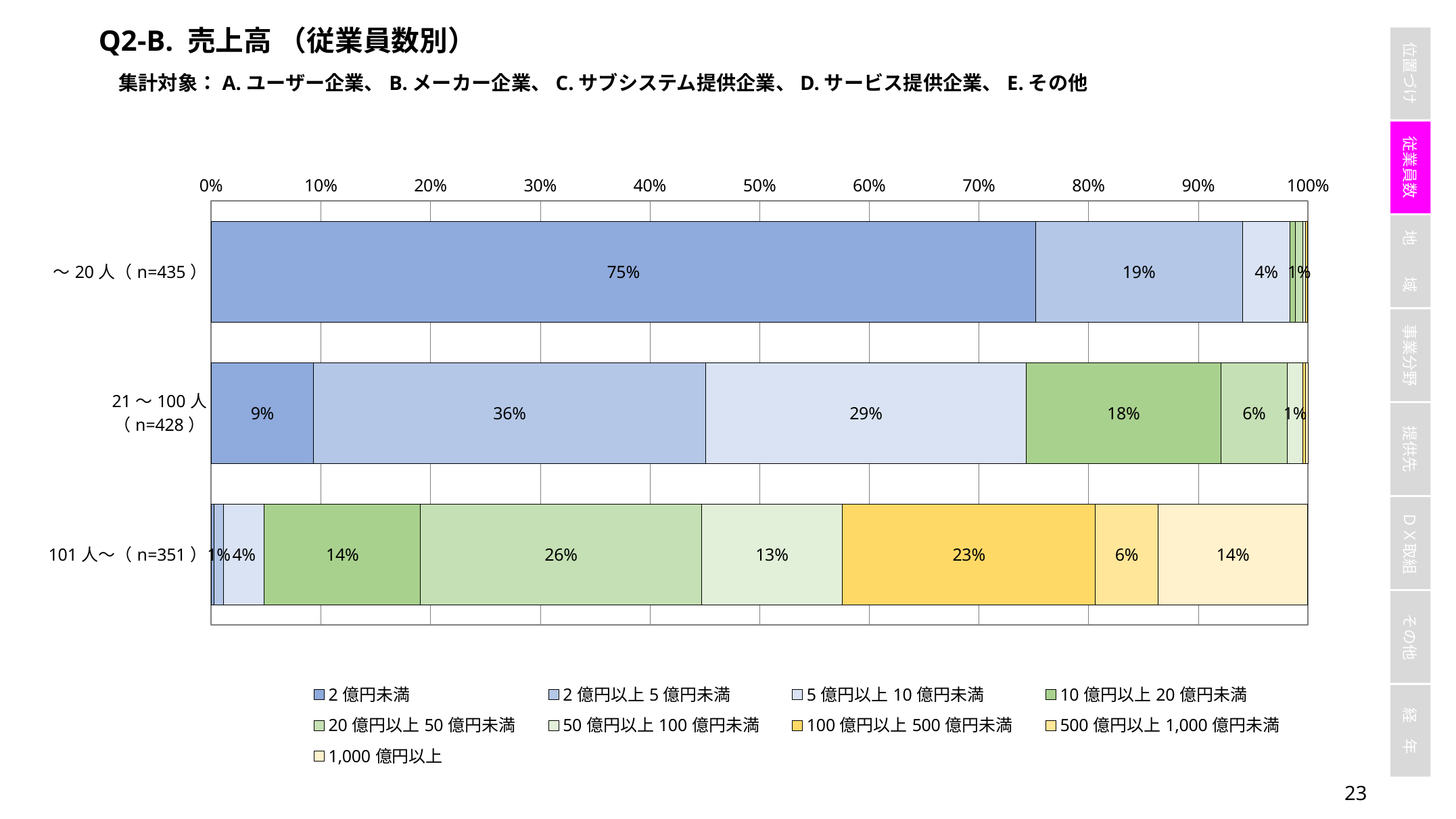
Which employee-size group has the largest share of 2億円未満? ～20人 (n=435) Which group has the larger share of 20億円以上50億円未満, 21～100人 or 101人～? 101人～ What is the difference in the 2億円未満 share between the ～20人 group and the 21～100人 group? 66 percentage points What is the share of 1,000億円以上 for the 101人～ (n=351) group? 14% What is the share of 5億円以上10億円未満 for the 21～100人 (n=428) group? 29% What kind of chart is shown on the slide? Stacked bar chart How many employee-size categories are plotted on the chart? 3 What is the share of 100億円以上500億円未満 for the 101人～ (n=351) group? 23% How many series does the legend list? 9 What is the share of 2億円以上5億円未満 for the ～20人 (n=435) group? 19% What is the share of 2億円以上5億円未満 for the 21～100人 (n=428) group? 36% What is the share of 2億円未満 for the ～20人 (n=435) group? 75%